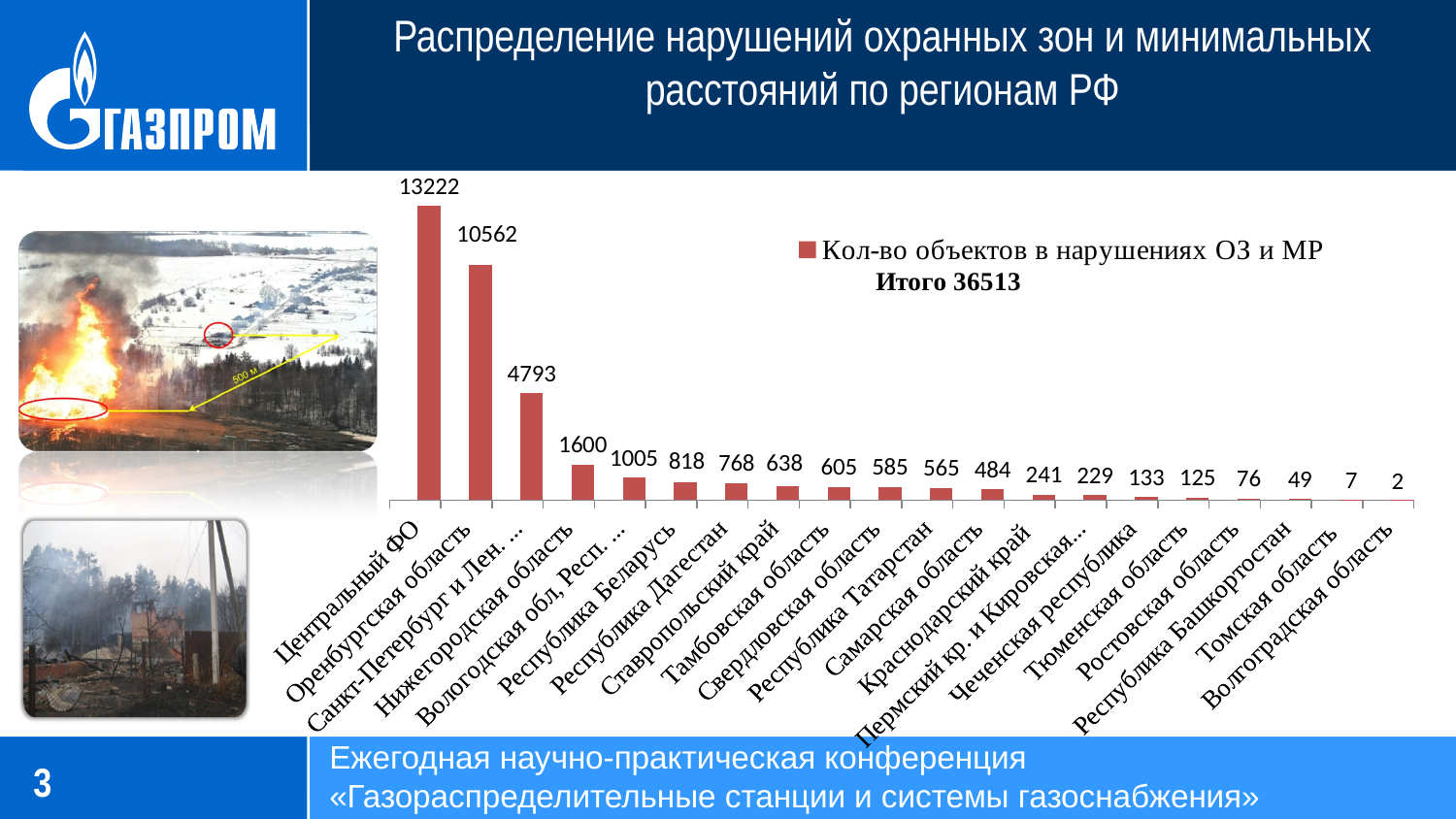
Which region has the lowest value? Волгоградская область What total (Итого) is stated next to the legend? 36513 What is the value for Оренбургская область? 10562 Which is larger, the value for Самарская область or Краснодарский край? Самарская область How many series does the legend list? 1 Do the values rise or fall from left to right along the x axis? fall What type of chart is shown? bar chart What is the value for Тюменская область? 125 How many regions are shown on the chart? 20 What is the difference between the values for Центральный ФО and Оренбургская область? 2660 What is the value for Республика Дагестан? 768 Which region has the highest value? Центральный ФО